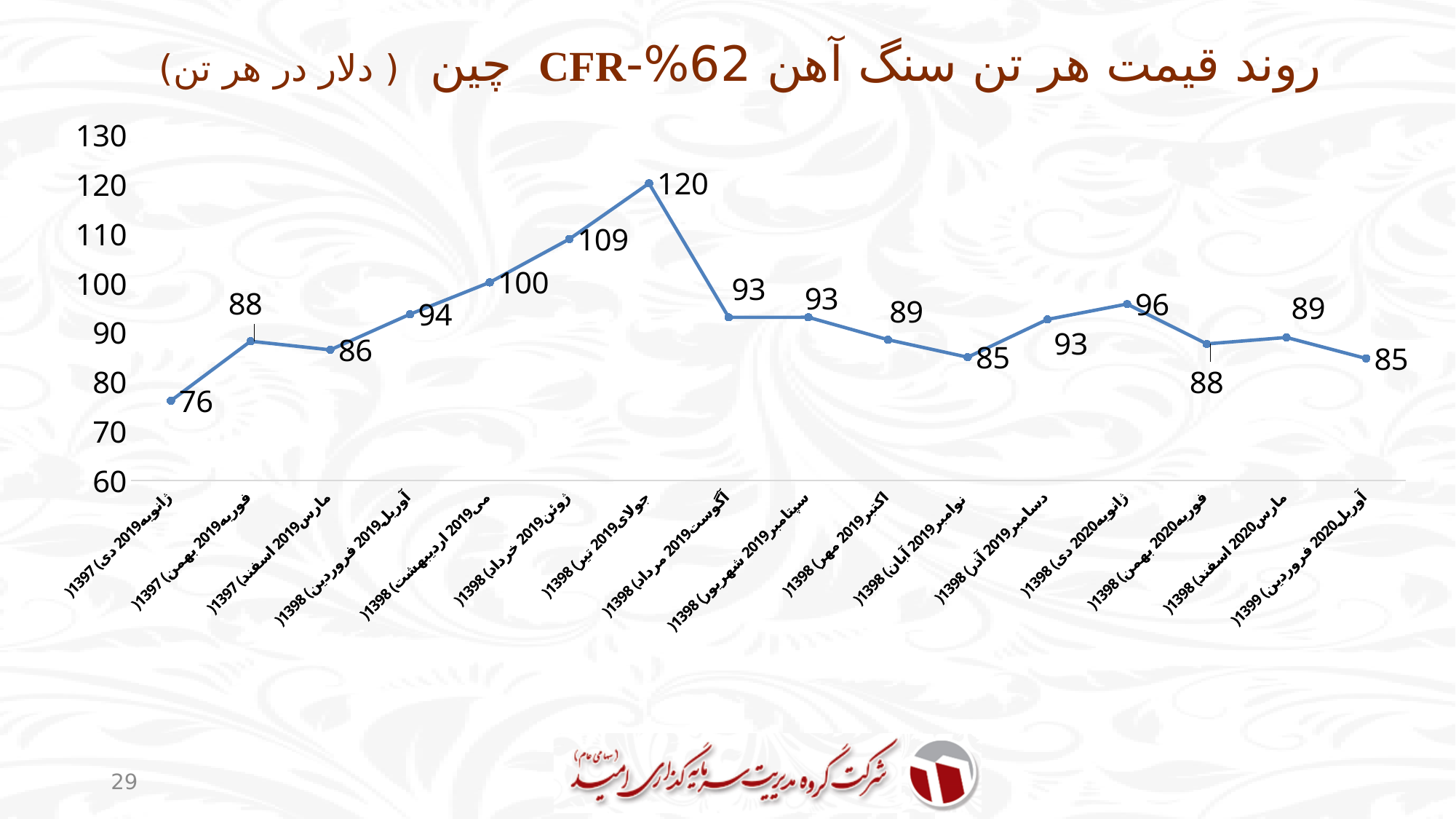
What is the difference between the values for July 2019 and August 2019? 27 Do the values rise or fall from January 2019 to July 2019? rise Which is larger, the value for June 2019 (ژوئن 2019) or the value for December 2019 (دسامبر 2019)? June 2019 Which month has the highest value? July 2019 (جولای 2019) Which month has the lowest value? January 2019 (ژانویه 2019) What is the value for April 2020 (آوریل 2020)? 85 What is the difference between the values for January 2019 and February 2019? 12 How many data points are plotted on the line? 16 What is the value for January 2019 (ژانویه 2019)? 76 What is the value for January 2020 (ژانویه 2020)? 96 What is the value for July 2019 (جولای 2019)? 120 What type of chart is shown on the slide? line chart